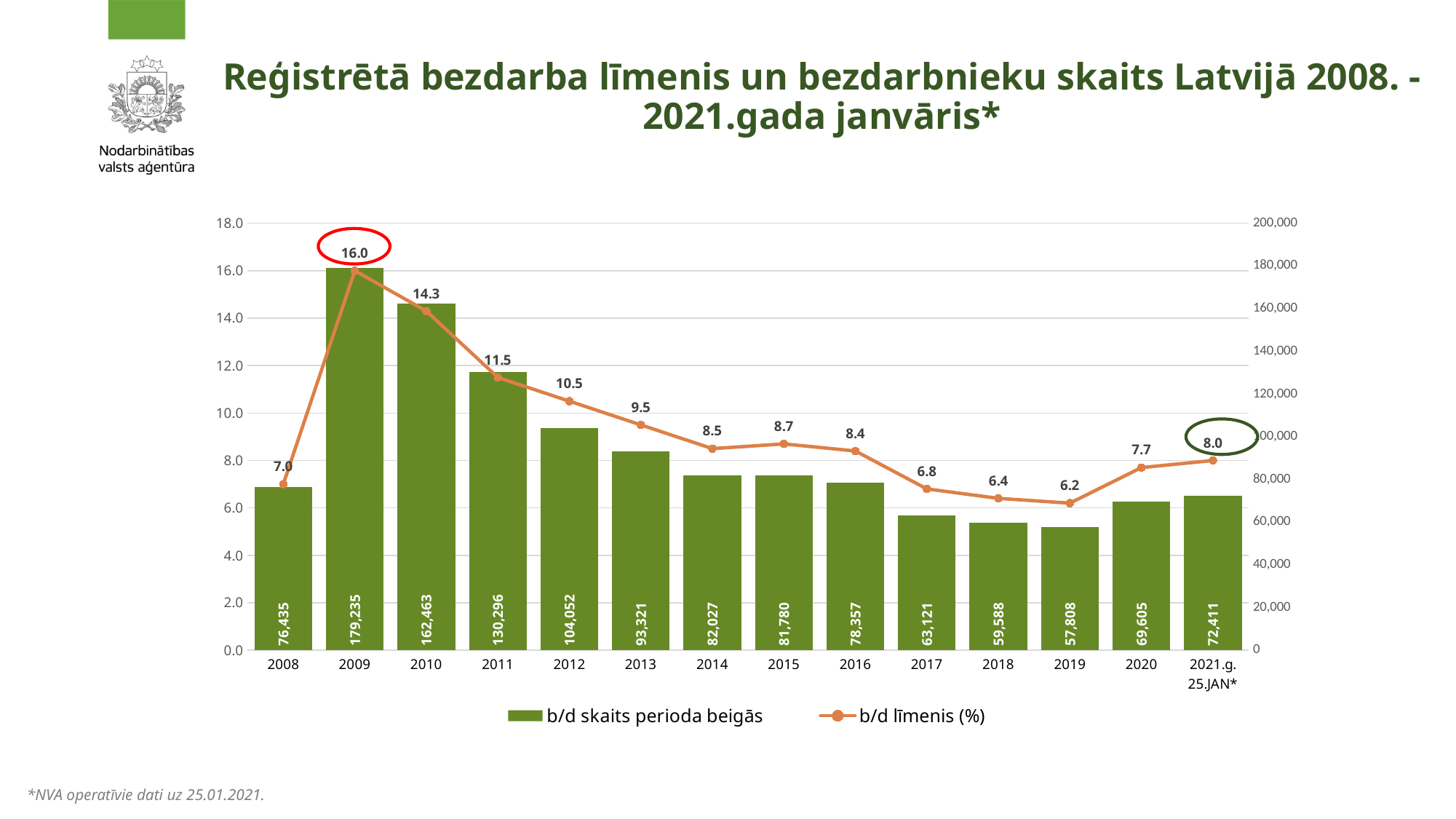
Does the 'b/d līmenis (%)' line rise or fall from 2009 to 2019? fall What is the 'b/d līmenis (%)' value for 2014? 8.5 How many series does the legend list? 2 Which year has the lowest 'b/d skaits perioda beigās' value? 2019 What kind of chart is used to show 'b/d skaits perioda beigās'? bar chart What is the 'b/d skaits perioda beigās' value for 2021.g. 25.JAN*? 72,411 What is the difference in 'b/d līmenis (%)' between 2020 and 2019? 1.5 Which is larger, the 'b/d līmenis (%)' value for 2015 or for 2016? 2015 What is the difference in 'b/d skaits perioda beigās' between 2009 and 2010? 16,772 How many years (categories) are shown on the x axis? 14 Which year has the highest 'b/d līmenis (%)' value? 2009 What is the value of 'b/d skaits perioda beigās' for 2009? 179,235